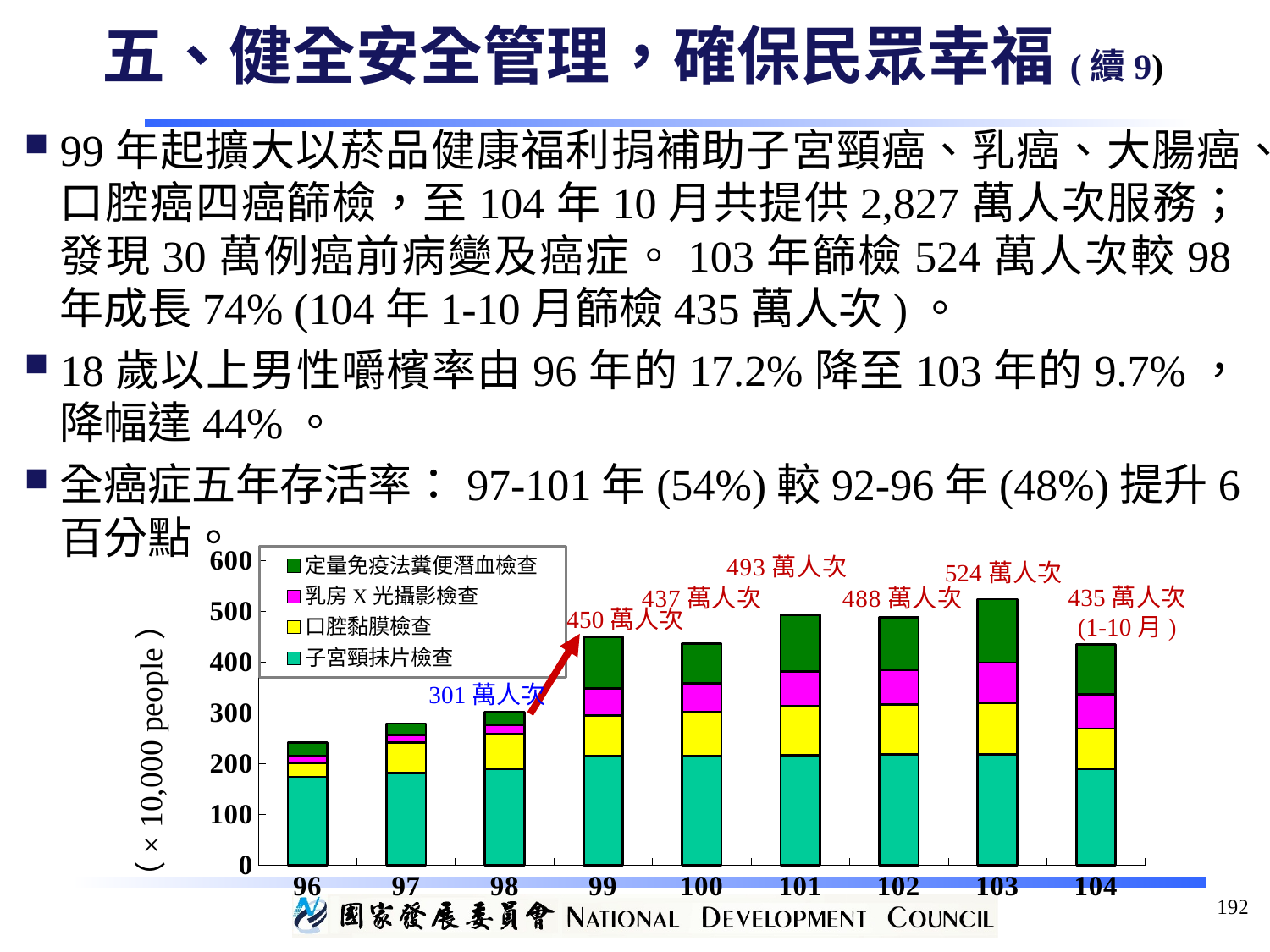
Which series is shown at the bottom of each stacked bar (teal colour)? 子宮頸抹片檢查 What total value is labelled for year 98 in the chart? 301 萬人次 What total value is labelled for year 103 in the chart? 524 萬人次 What kind of chart is shown at the bottom of the slide? stacked bar chart Which year has the lowest total in the chart? 96 How many series does the chart legend list? 4 Which year has the larger labelled total, 101 or 102? 101 What is the difference between the labelled totals for year 103 and year 98? 223 萬人次 What total value is labelled for year 101 in the chart? 493 萬人次 Is the total for year 96 greater or less than 300? less How many years (categories) are shown on the x axis of the chart? 9 Which year has the highest total in the chart? 103